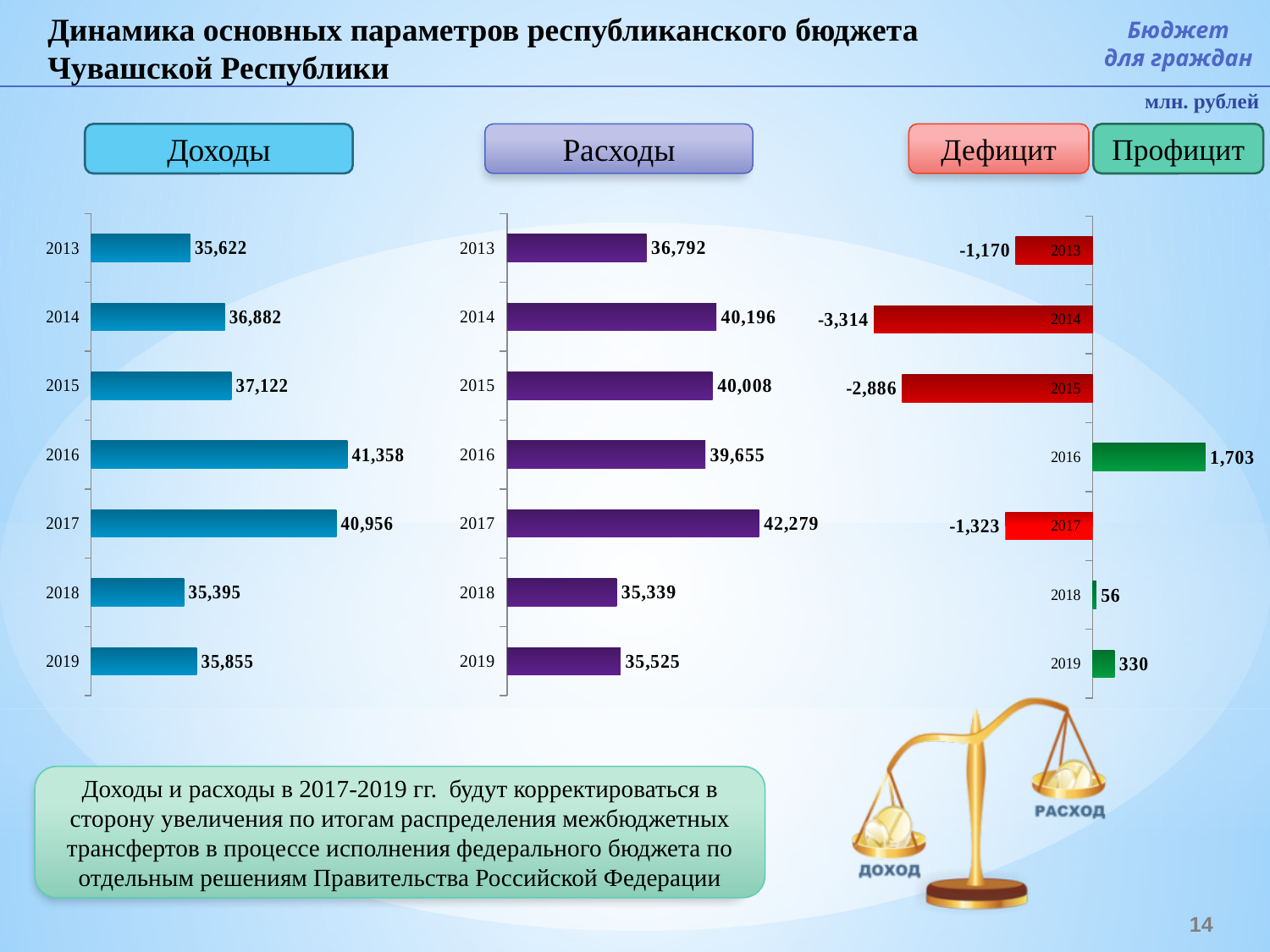
What type of chart is the Расходы chart? bar chart In what units are the values on the charts expressed, according to the slide? млн. рублей On the Дефицит/Профицит chart, what is the value for 2014? -3,314 On the Доходы chart, which year has the highest value? 2016 On the Доходы chart, what is the difference between the values for 2016 and 2017? 402 On the Доходы chart, what is the value for 2016? 41,358 On the Расходы chart, what is the value for 2017? 42,279 What is the difference between the Расходы value for 2017 and the Доходы value for 2017? 1,323 On the Дефицит/Профицит chart, which year has the largest surplus (профицит)? 2016 How many years are shown on the Доходы chart? 7 On the Расходы chart, which year has the lowest value? 2018 On the Доходы chart, which is larger: the value for 2014 or the value for 2015? 2015